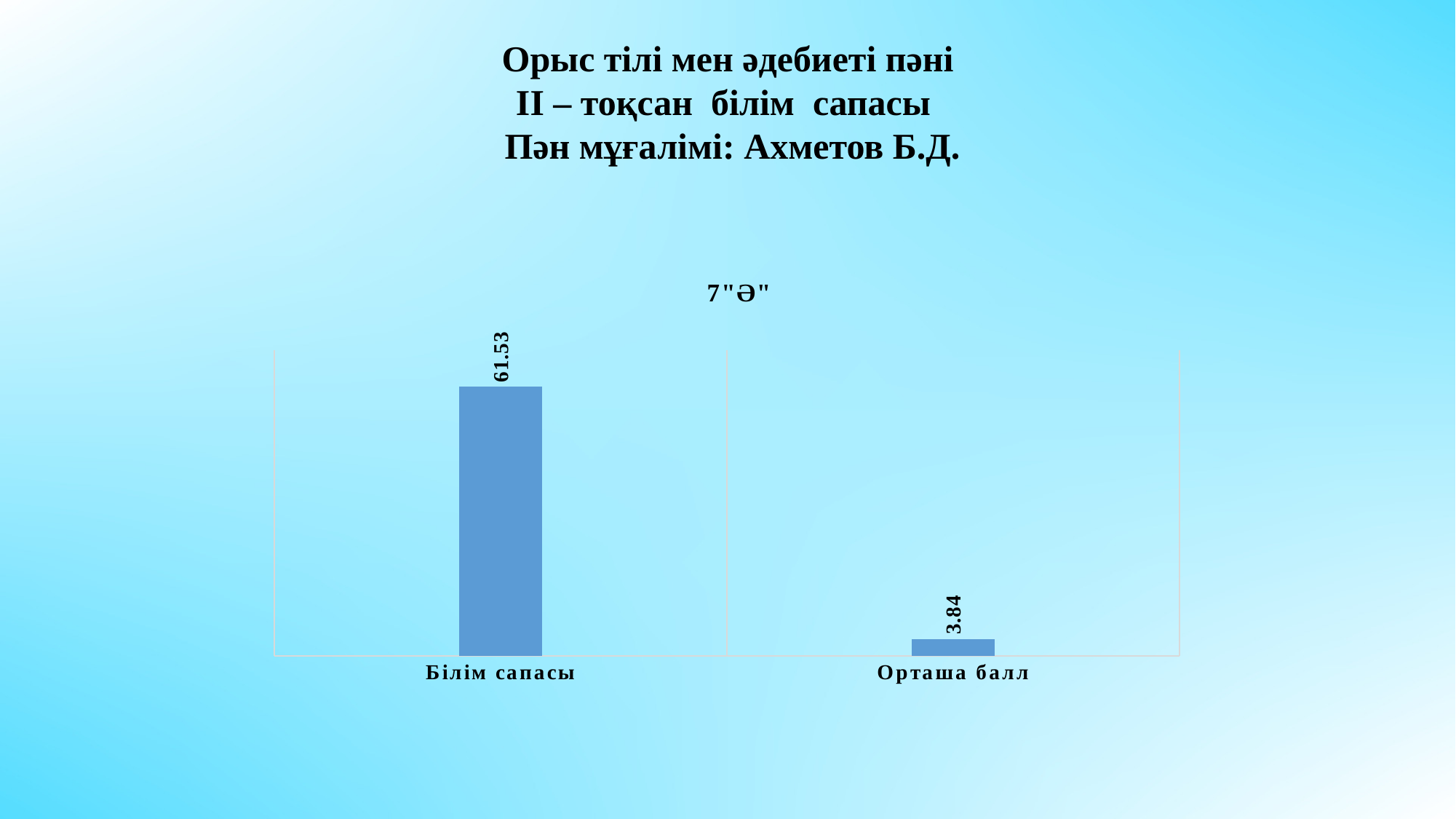
What is the difference between the values for Білім сапасы and Орташа балл? 57.69 Which is larger, the value for Білім сапасы or the value for Орташа балл? Білім сапасы What is the title of the chart? 7"Ә" Which category has the lowest value? Орташа балл What is the value for Білім сапасы? 61.53 How many categories are shown in the chart? 2 What colour are the bars in the chart? Blue What is the value for Орташа балл? 3.84 Which category has the highest value? Білім сапасы What kind of chart is shown on the slide? Bar chart